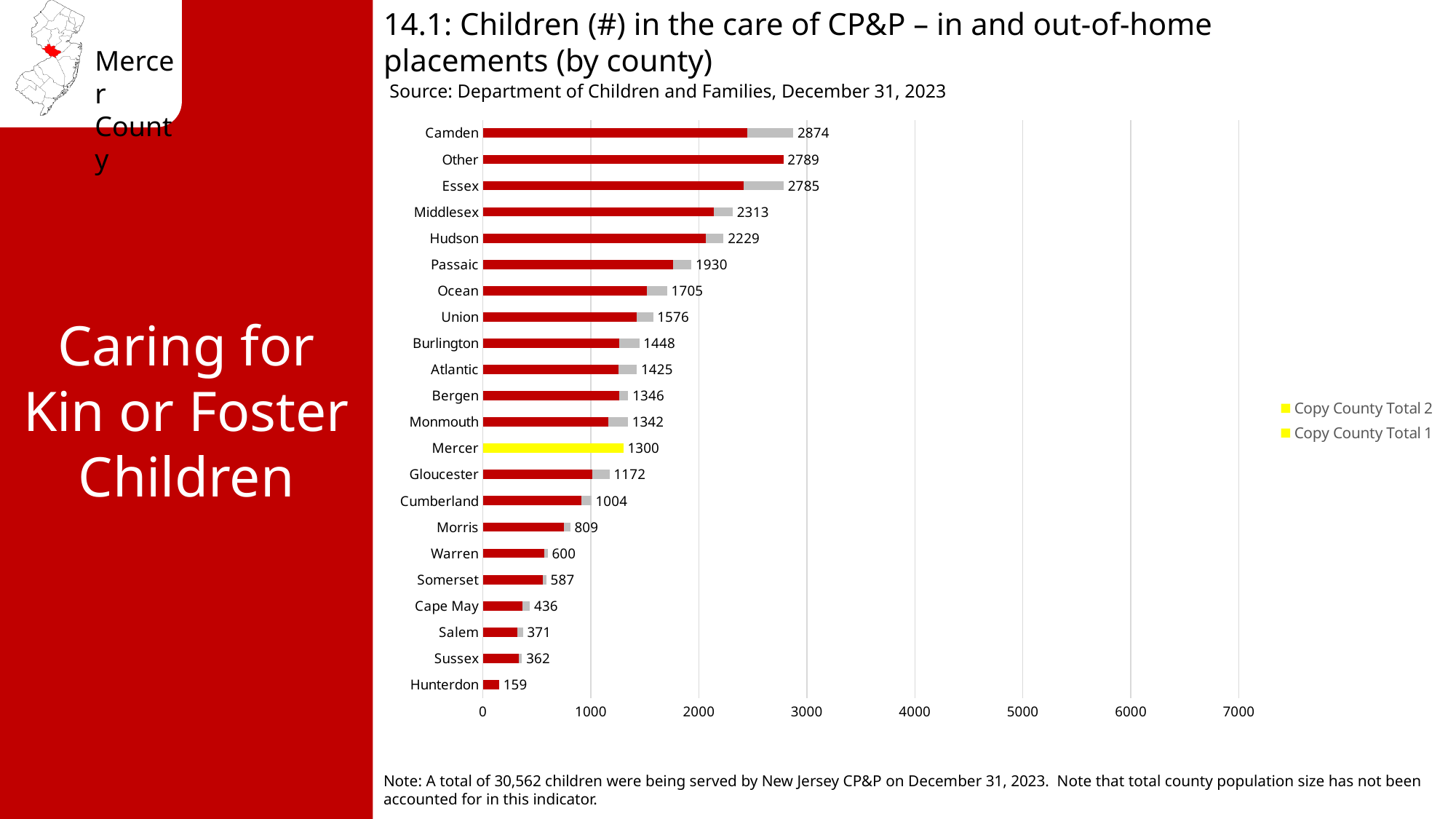
What is the value shown for Camden? 2874 Which county has the highest number of children in the care of CP&P? Camden How many series does the legend list? 2 How many counties/categories are shown on the chart? 22 What is the difference between the values for Camden and Mercer? 1574 What kind of chart is shown on the slide? Bar chart Which county has the lowest number of children in the care of CP&P? Hunterdon Which has a larger value, Bergen or Monmouth? Bergen What is the value shown for Hunterdon? 159 Is the value for Middlesex greater or less than 2000? greater What is the total number of children in the care of CP&P for Mercer County? 1300 What is the value shown for Passaic? 1930